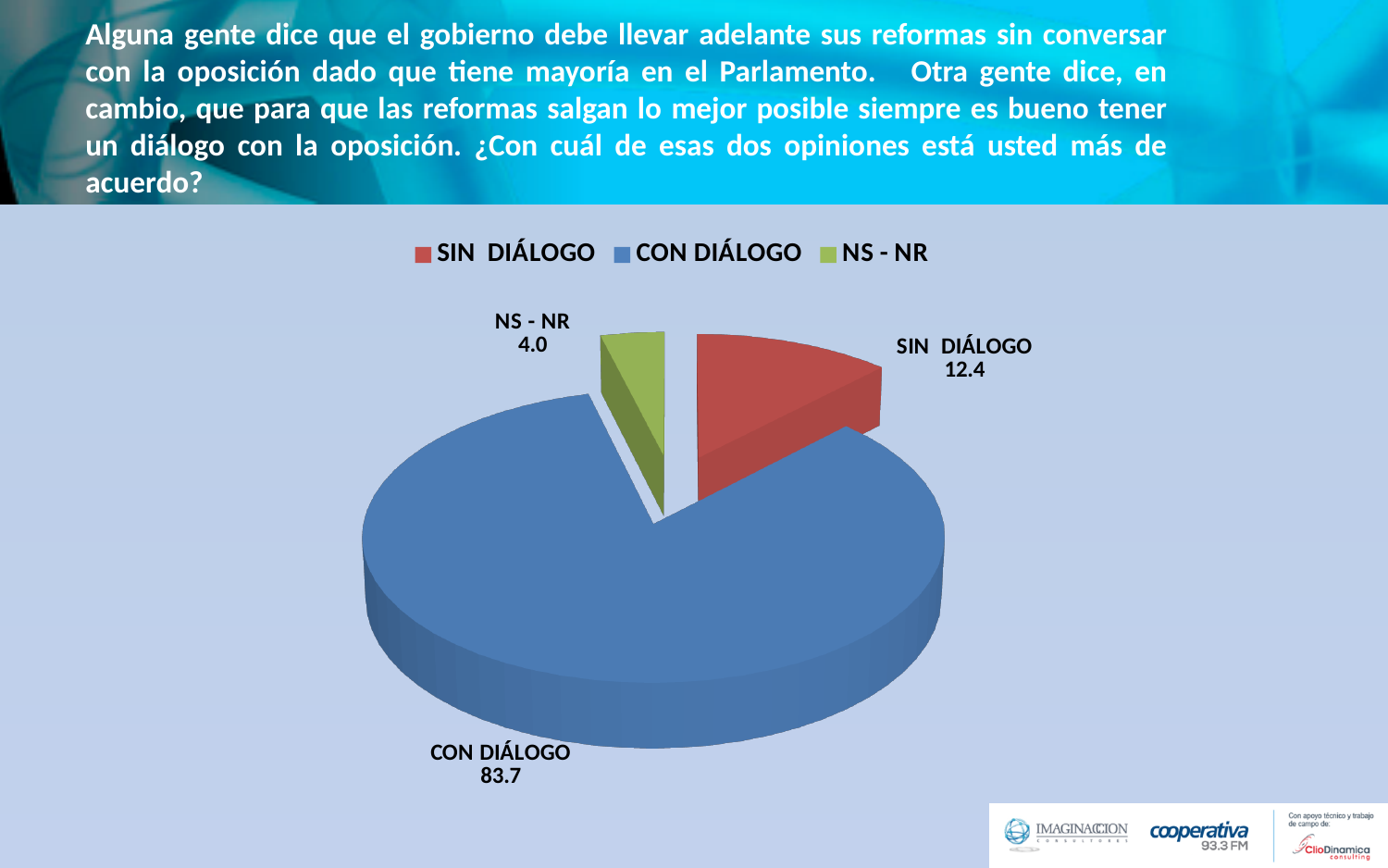
What is the value for SIN DIÁLOGO? 12.4 How many entries does the legend list? 3 Which is larger, SIN DIÁLOGO or NS - NR? SIN DIÁLOGO What is the value for NS - NR? 4.0 What is the difference between the values for SIN DIÁLOGO and NS - NR? 8.4 How many slices does the pie chart have? 3 What kind of chart is shown on the slide? pie chart What is the value for CON DIÁLOGO? 83.7 Which category has the largest slice? CON DIÁLOGO Which category has the smallest slice? NS - NR What colour is the CON DIÁLOGO slice? blue What is the difference between the values for CON DIÁLOGO and SIN DIÁLOGO? 71.3